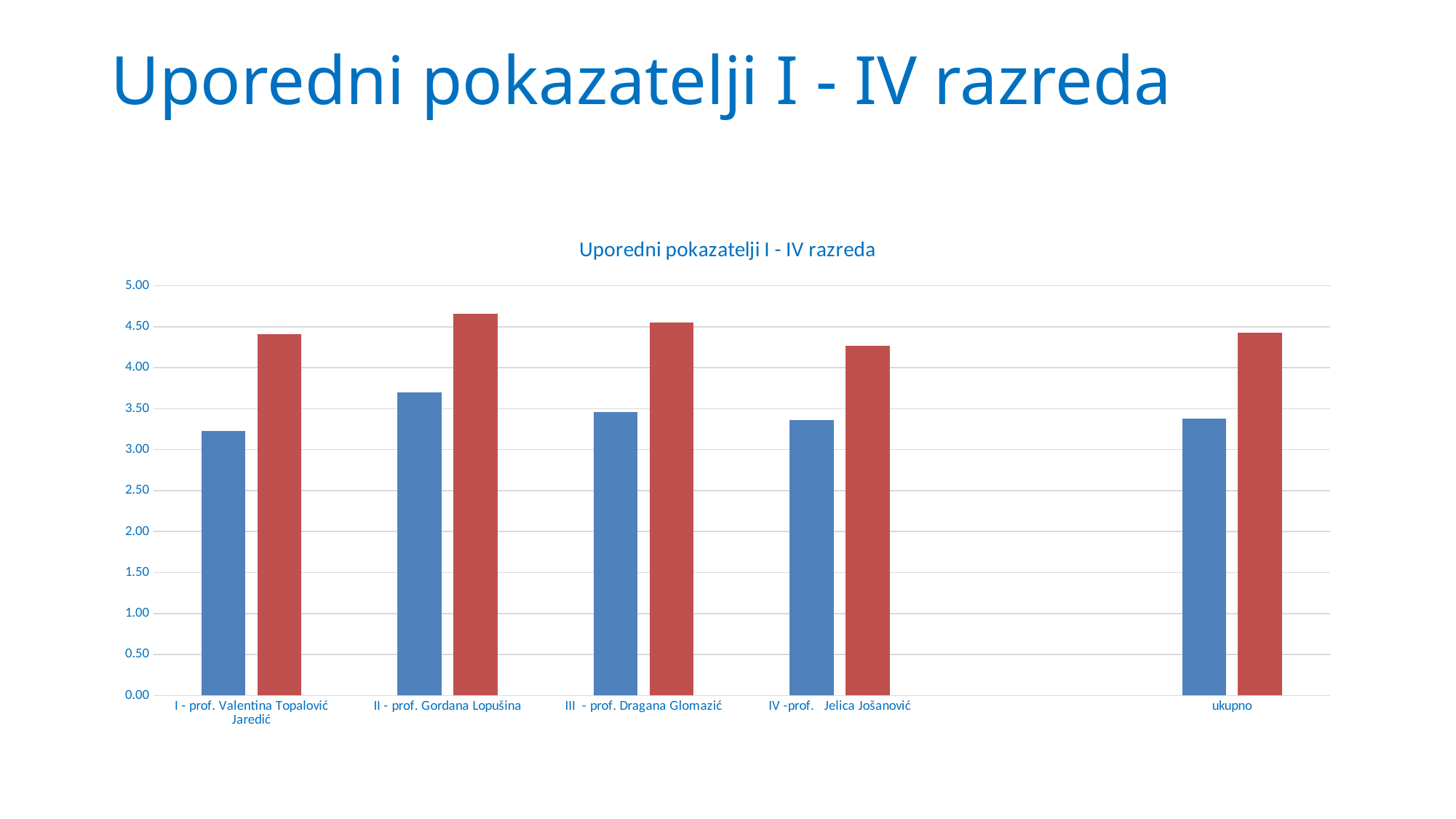
Is the blue bar for 'II - prof. Gordana Lopušina' greater or less than 3.50? greater Is the blue bar for 'I - prof. Valentina Topalović Jaredić' greater or less than 3.50? less Is the red bar for 'IV -prof. Jelica Jošanović' greater or less than 4.50? less Which category has the highest blue bar? II - prof. Gordana Lopušina For 'ukupno', which bar is taller, the blue one or the red one? the red one What kind of chart is shown on the slide? bar chart What is the title of the chart? Uporedni pokazatelji I - IV razreda How many labelled categories are shown on the x axis of the chart? 5 Which category has the lowest red bar? IV -prof. Jelica Jošanović Which category has the lowest blue bar? I - prof. Valentina Topalović Jaredić